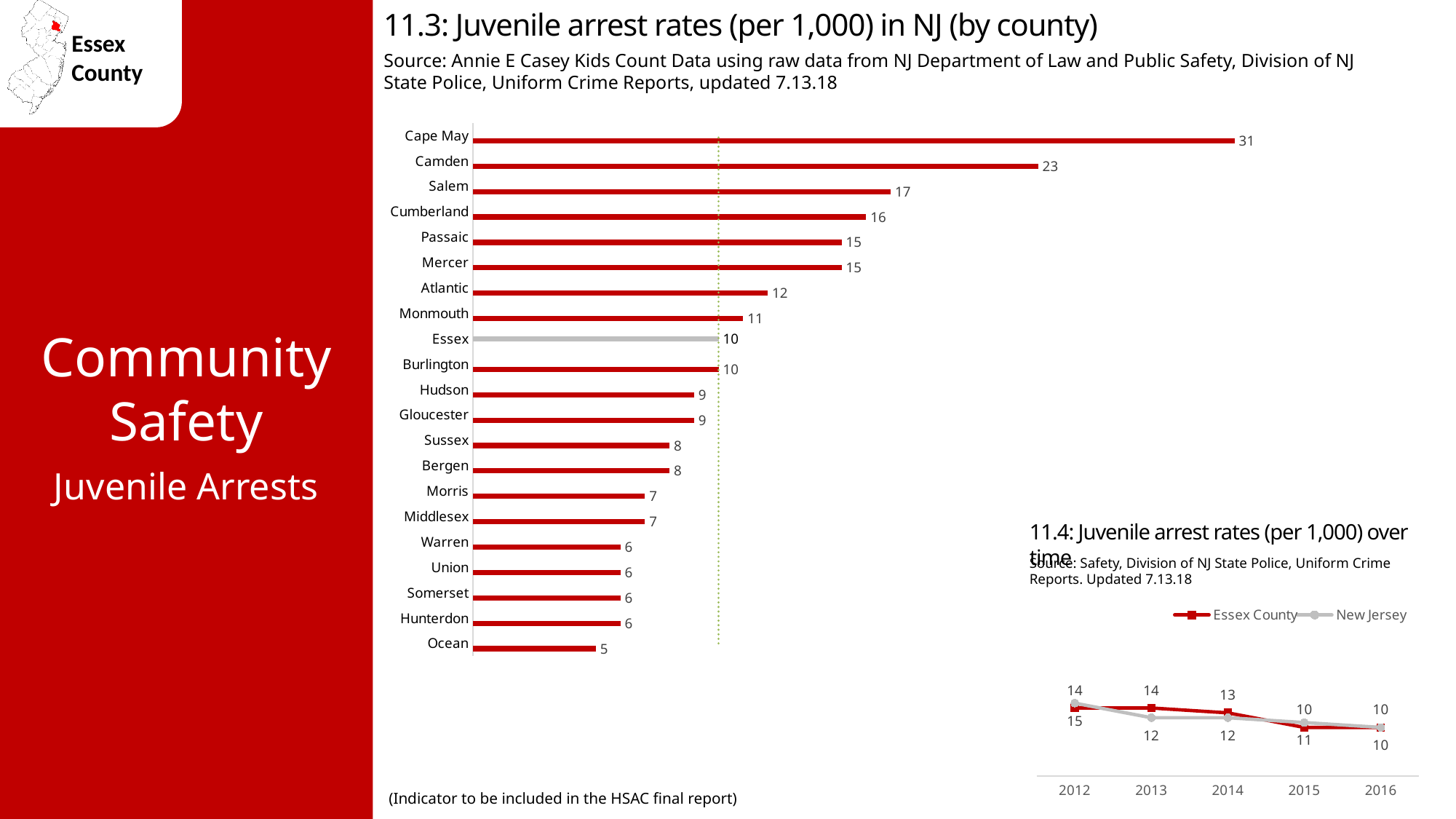
In chart 11.4 (juvenile arrest rates over time), how many series does the legend list? 2 In chart 11.3 (juvenile arrest rates by county), how many counties are shown? 21 In chart 11.3 (juvenile arrest rates by county), what is the value for Essex? 10 In chart 11.3 (juvenile arrest rates by county), which is larger, Passaic or Monmouth? Passaic In chart 11.3 (juvenile arrest rates by county), which county has the lowest rate? Ocean In chart 11.3 (juvenile arrest rates by county), which county has the highest rate? Cape May What kind of chart is chart 11.3 (juvenile arrest rates by county)? Bar chart In chart 11.3 (juvenile arrest rates by county), what is the value for Cape May? 31 In chart 11.4 (juvenile arrest rates over time), do the values generally rise or fall from 2012 to 2016? Fall In chart 11.3 (juvenile arrest rates by county), which county's bar is shown in grey instead of red? Essex In chart 11.3 (juvenile arrest rates by county), what is the difference between Camden and Salem? 6 In chart 11.3 (juvenile arrest rates by county), what is the value for Atlantic? 12